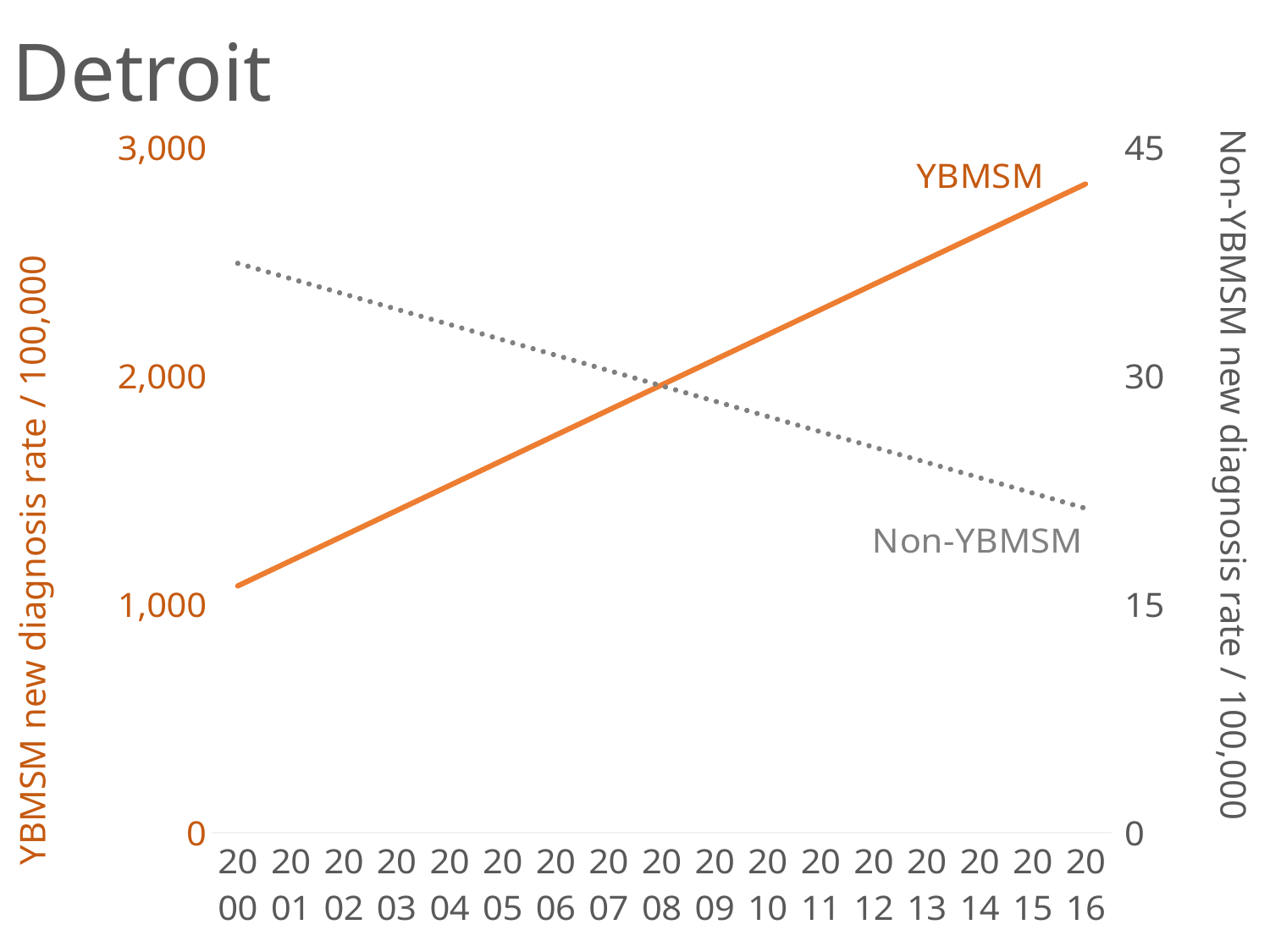
How many data series are plotted on the chart? 2 How many years are shown along the x axis? 17 Does the Non-YBMSM new diagnosis rate rise or fall from 2000 to 2016? fall What is the title of the chart? Detroit Is the Non-YBMSM value for 2016 greater or less than 30? less Is the Non-YBMSM value for 2000 greater or less than 30? greater What kind of chart is shown on the slide? line chart Which series is drawn as a dotted line? Non-YBMSM Does the YBMSM new diagnosis rate rise or fall from 2000 to 2016? rise Is the YBMSM value for 2016 greater or less than 2,000? greater